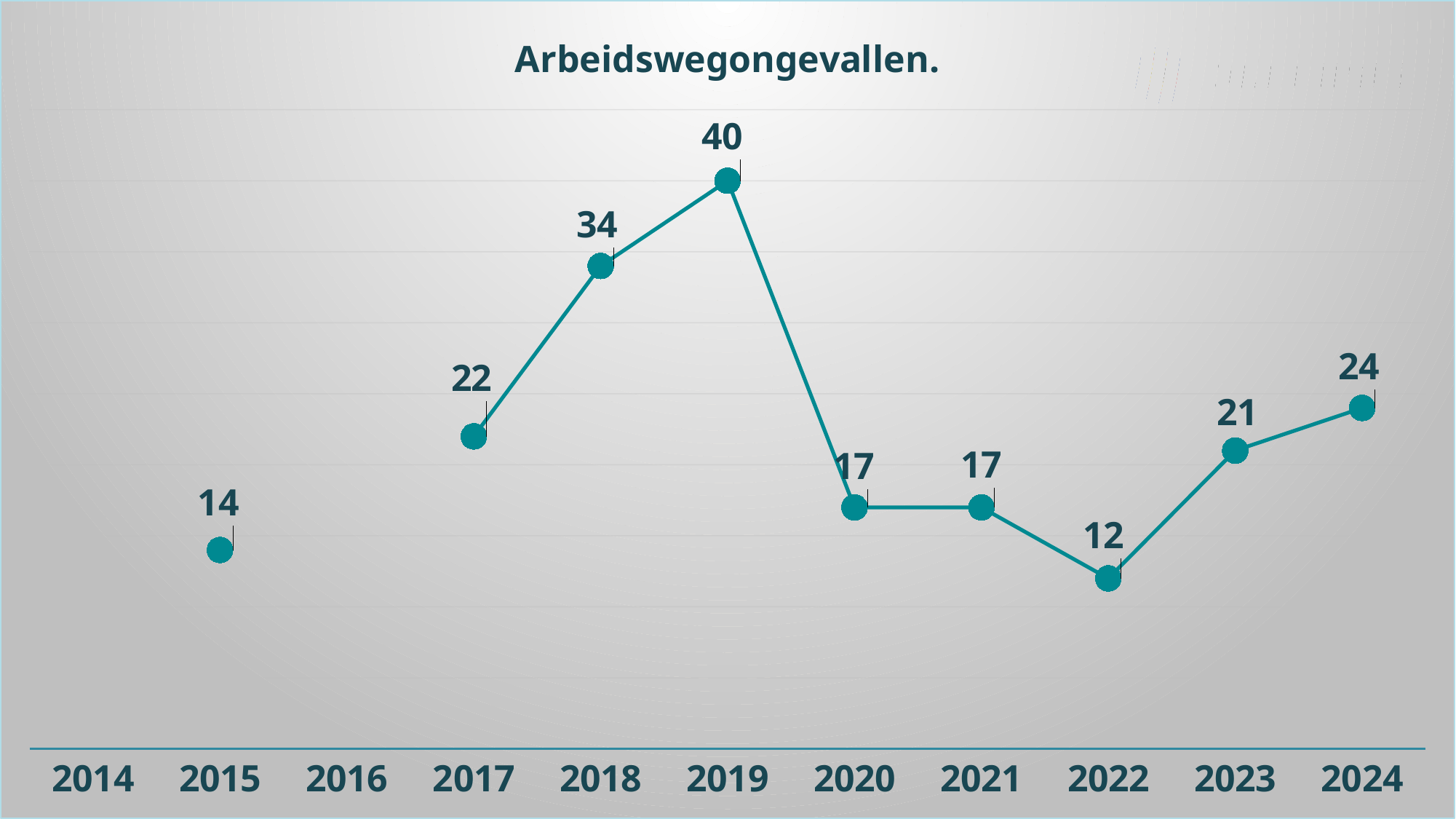
Do the values rise or fall from 2022 to 2024? rise Which year has the highest value? 2019 What is the value for 2019? 40 Which is larger, the value for 2017 or the value for 2023? 2017 Which year has the lowest value? 2022 What is the difference between the values for 2019 and 2018? 6 What is the difference between the values for 2024 and 2022? 12 How many data points are plotted on the line? 9 What kind of chart is shown? line chart What is the value for 2022? 12 What is the value for 2015? 14 What is the value for 2024? 24